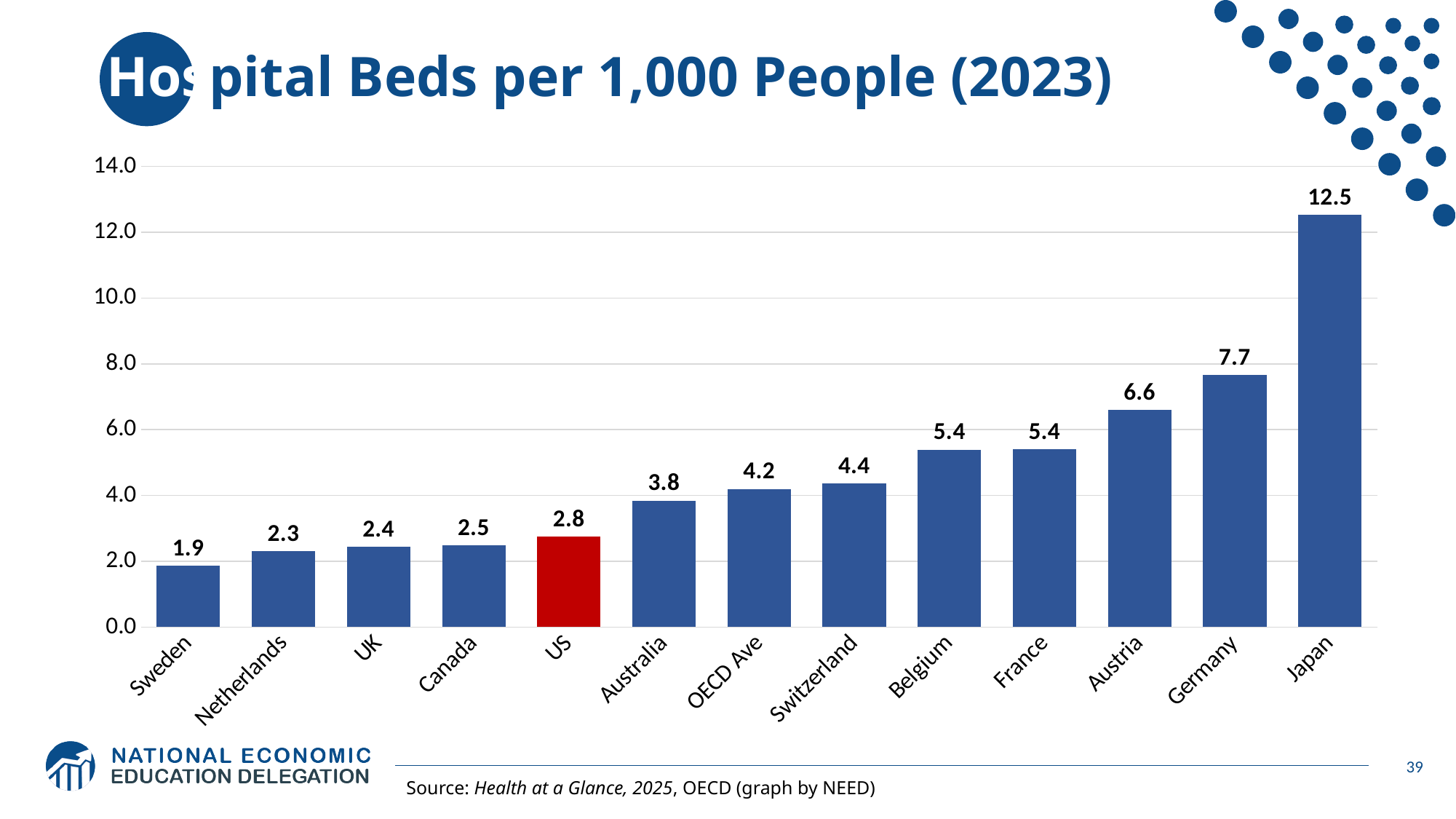
Which category has the lowest value? Sweden What is the value for the OECD Ave? 4.2 What is the value for Japan? 12.5 Which bar is coloured red? US How many categories are shown on the x axis? 13 Is the value for Austria greater or less than 6.0? greater What is the value for the US? 2.8 What is the difference between the values for the OECD Ave and the US? 1.4 Which is larger, the value for Australia or the value for Canada? Australia What is the difference between the values for Germany and the US? 4.9 What kind of chart is this? bar chart Which category has the highest value? Japan